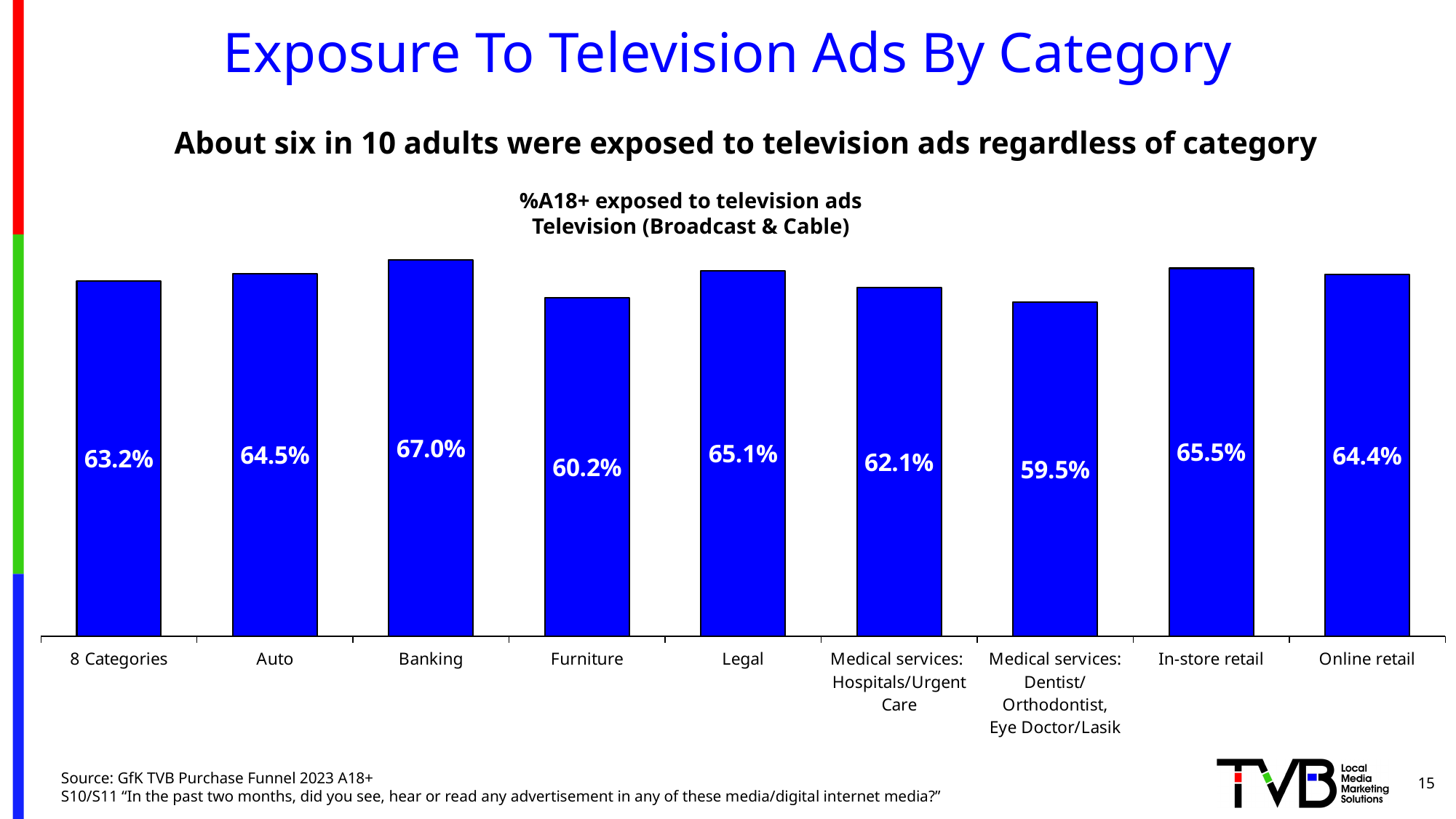
What is the chart's title? %A18+ exposed to television ads Television (Broadcast & Cable) Which is larger, the value for Legal or the value for Auto? Legal What percentage of adults 18+ were exposed to television ads for Banking? 67.0% Which category has the highest percentage of adults exposed to television ads? Banking What is the value shown for Furniture? 60.2% How many categories are shown on the x axis? 9 Which category has the lowest percentage of adults exposed to television ads? Medical services: Dentist/Orthodontist, Eye Doctor/Lasik What percentage is shown for Medical services: Dentist/Orthodontist, Eye Doctor/Lasik? 59.5% What is the value for the 8 Categories bar? 63.2% What is the difference in percentage points between Banking and Furniture? 6.8 What is the difference in percentage points between In-store retail and Online retail? 1.1 What kind of chart is shown on the slide? Bar chart